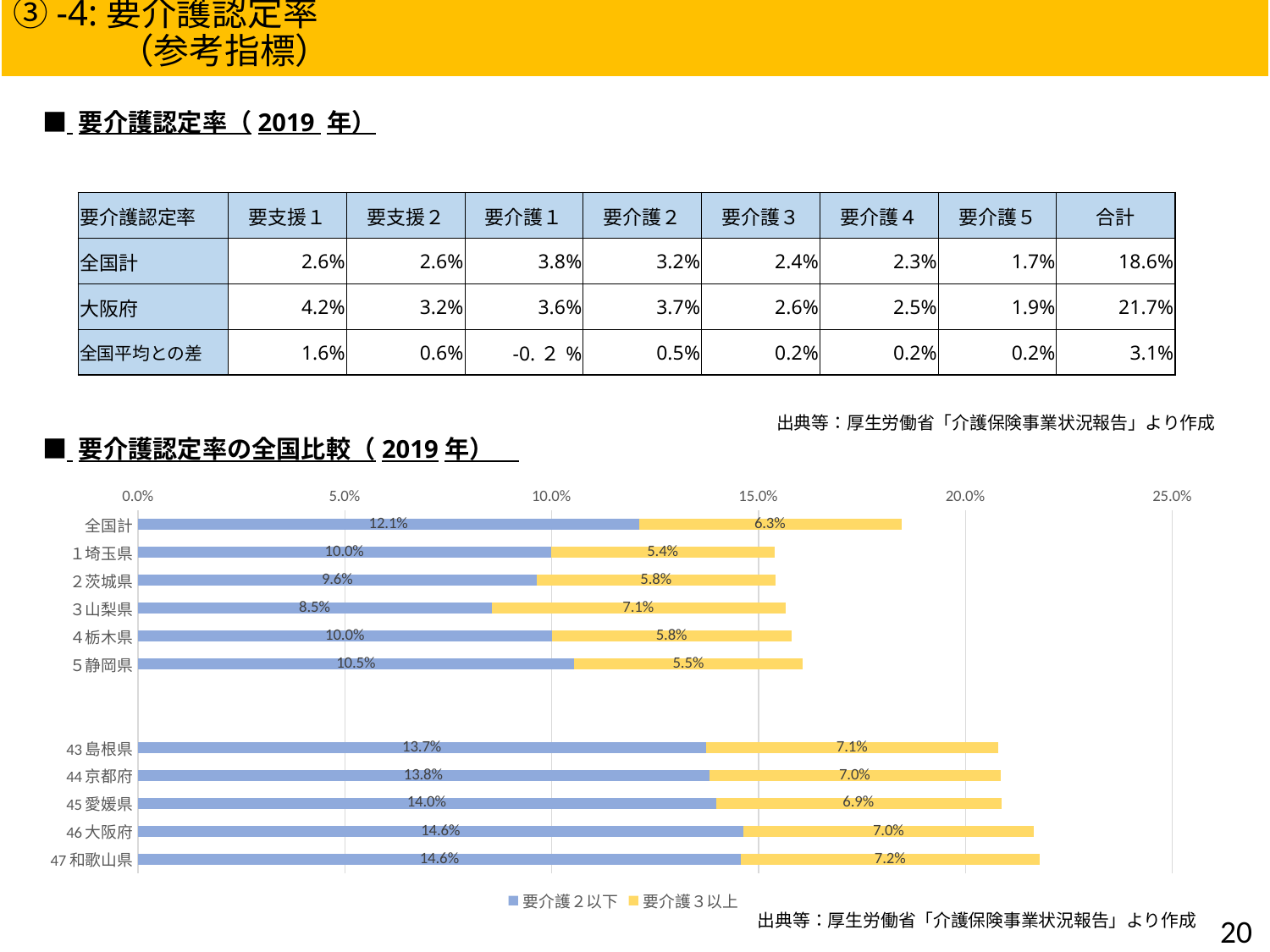
What type of chart is shown under 要介護認定率の全国比較（2019年）? Stacked bar chart What is the total of the stacked bar for 47和歌山県? 21.8% Which has the larger 要介護２以下 value, 5静岡県 or 2茨城県? 5静岡県 Which category has the highest 要介護３以上 value in the chart? 47和歌山県 What is the 要介護２以下 value for 46大阪府 in the chart? 14.6% How many series does the legend of the chart list? 2 Which series is shown in yellow in the chart? 要介護３以上 What is the 要介護３以上 value for 全国計 in the chart? 6.3% Which category has the lowest 要介護２以下 value in the chart? 3山梨県 What is the difference between the 要介護２以下 values of 46大阪府 and 全国計? 2.5% What is the 要介護３以上 value for 3山梨県 in the chart? 7.1% How many categories (rows) are plotted in the chart? 11